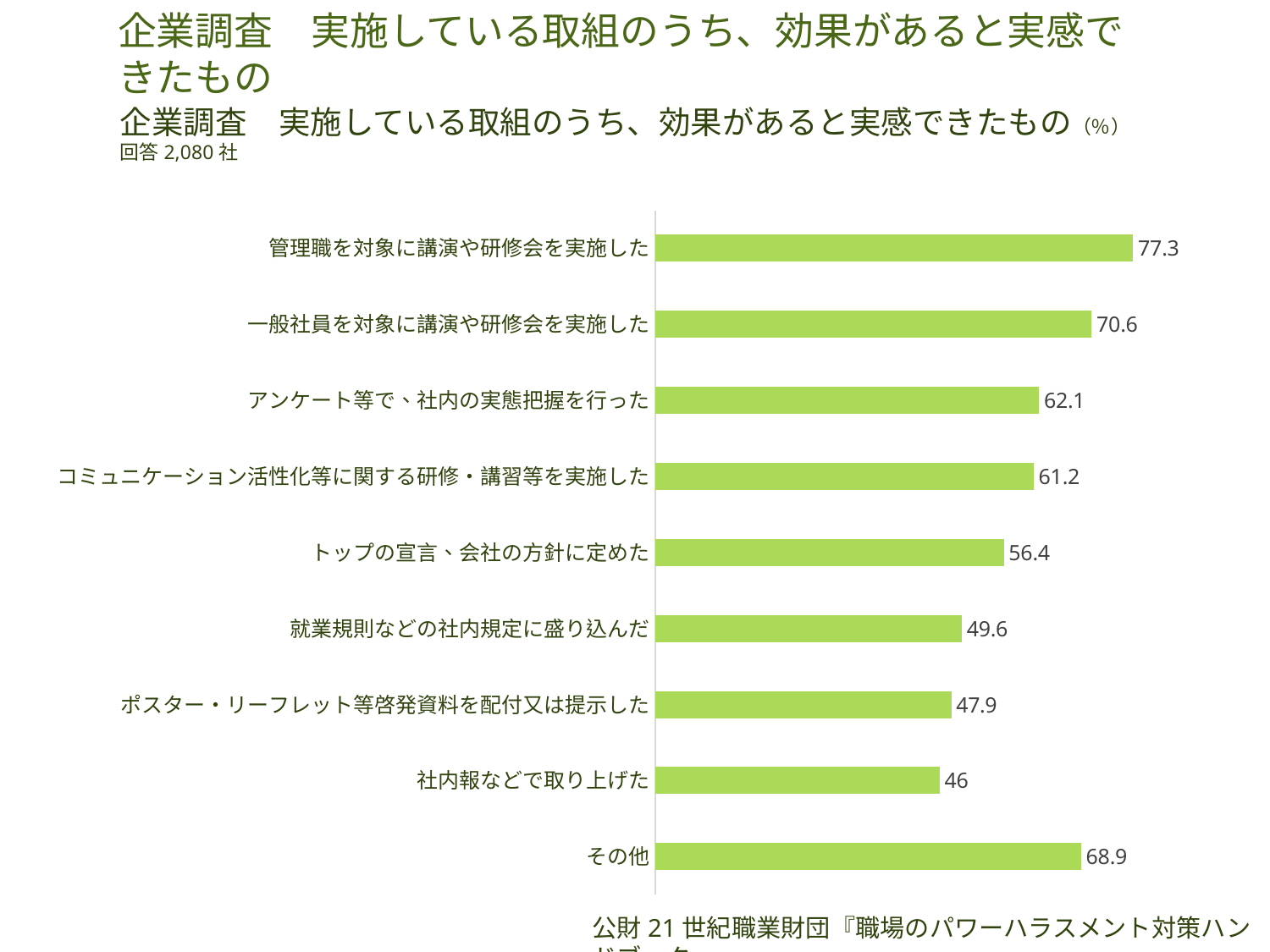
What is the value for 管理職を対象に講演や研修会を実施した? 77.3 What kind of chart is shown on the slide? bar chart What is the value for 社内報などで取り上げた? 46 What is the value for トップの宣言、会社の方針に定めた? 56.4 What is the difference between the values for 就業規則などの社内規定に盛り込んだ and 社内報などで取り上げた? 3.6 How many categories are shown in the chart? 9 Which category has the lowest value? 社内報などで取り上げた Which is larger, the value for アンケート等で、社内の実態把握を行った or the value for その他? その他 What is the difference between the values for 管理職を対象に講演や研修会を実施した and 一般社員を対象に講演や研修会を実施した? 6.7 Which category has the highest value? 管理職を対象に講演や研修会を実施した What is the value for その他? 68.9 How many companies responded to the survey, according to the slide? 2,080 社